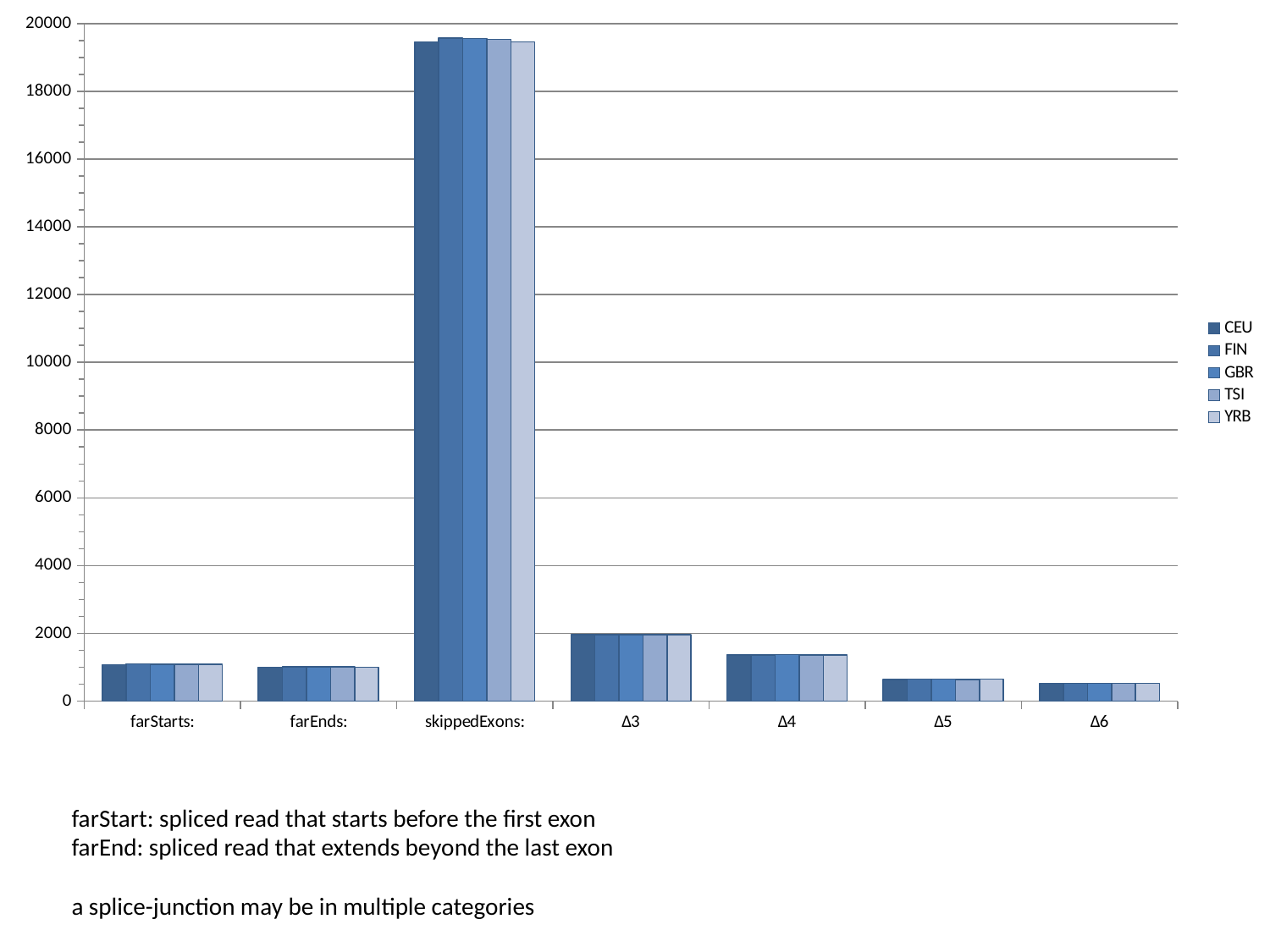
Is the CEU value for Δ3 greater or less than 4000? less Which is larger for the TSI series: the value for skippedExons: or the value for farEnds:? skippedExons: How many categories are shown on the x axis of the chart? 7 Which series is listed last in the chart's legend? YRB Which series is listed first in the chart's legend? CEU What kind of chart is shown on the slide? bar chart Is the CEU value for skippedExons: greater or less than 18000? greater Is the YRB value for farStarts: greater or less than 2000? less Which is larger for the CEU series: the value for Δ3 or the value for Δ4? Δ3 How many series does the chart's legend list? 5 Which category has the highest values in the chart? skippedExons: